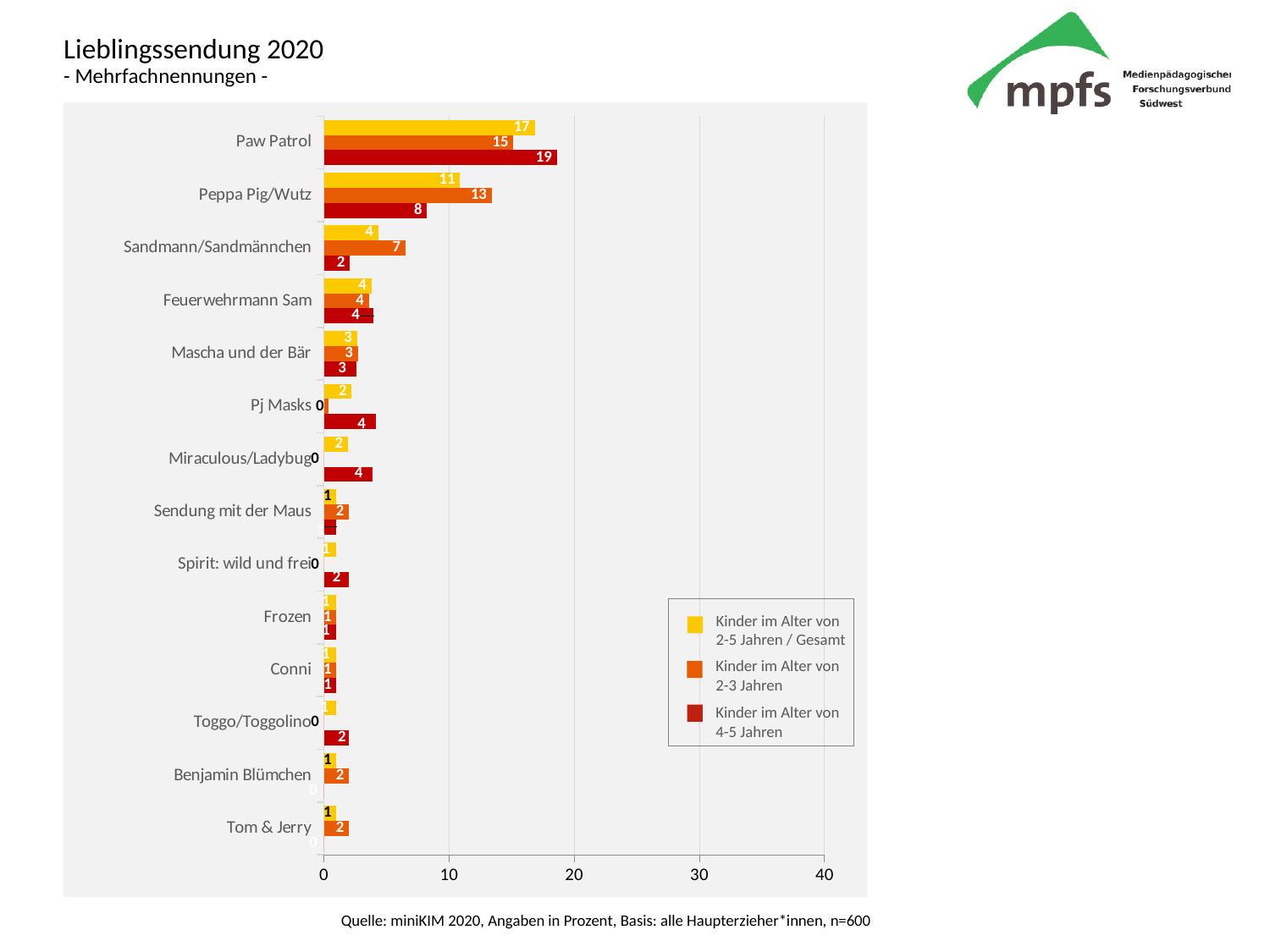
What is the title of the chart? Lieblingssendung 2020 - Mehrfachnennungen - How many series does the legend list? 3 What is the value for Sandmann/Sandmännchen among Kinder im Alter von 2-5 Jahren / Gesamt? 4 What is the difference between the Paw Patrol values for Kinder im Alter von 4-5 Jahren and Kinder im Alter von 2-3 Jahren? 4 For Peppa Pig/Wutz, which is larger: the value for Kinder im Alter von 2-3 Jahren or for Kinder im Alter von 4-5 Jahren? Kinder im Alter von 2-3 Jahren What is the value for Paw Patrol among Kinder im Alter von 4-5 Jahren? 19 What is the value for Peppa Pig/Wutz among Kinder im Alter von 2-3 Jahren? 13 How many programmes (categories) are shown on the chart? 14 What kind of chart is shown on the slide? bar chart Which programme has the highest value among Kinder im Alter von 2-5 Jahren / Gesamt? Paw Patrol Is the value for Paw Patrol among Kinder im Alter von 2-5 Jahren / Gesamt greater or less than 10? greater What is the value for Pj Masks among Kinder im Alter von 2-3 Jahren? 0